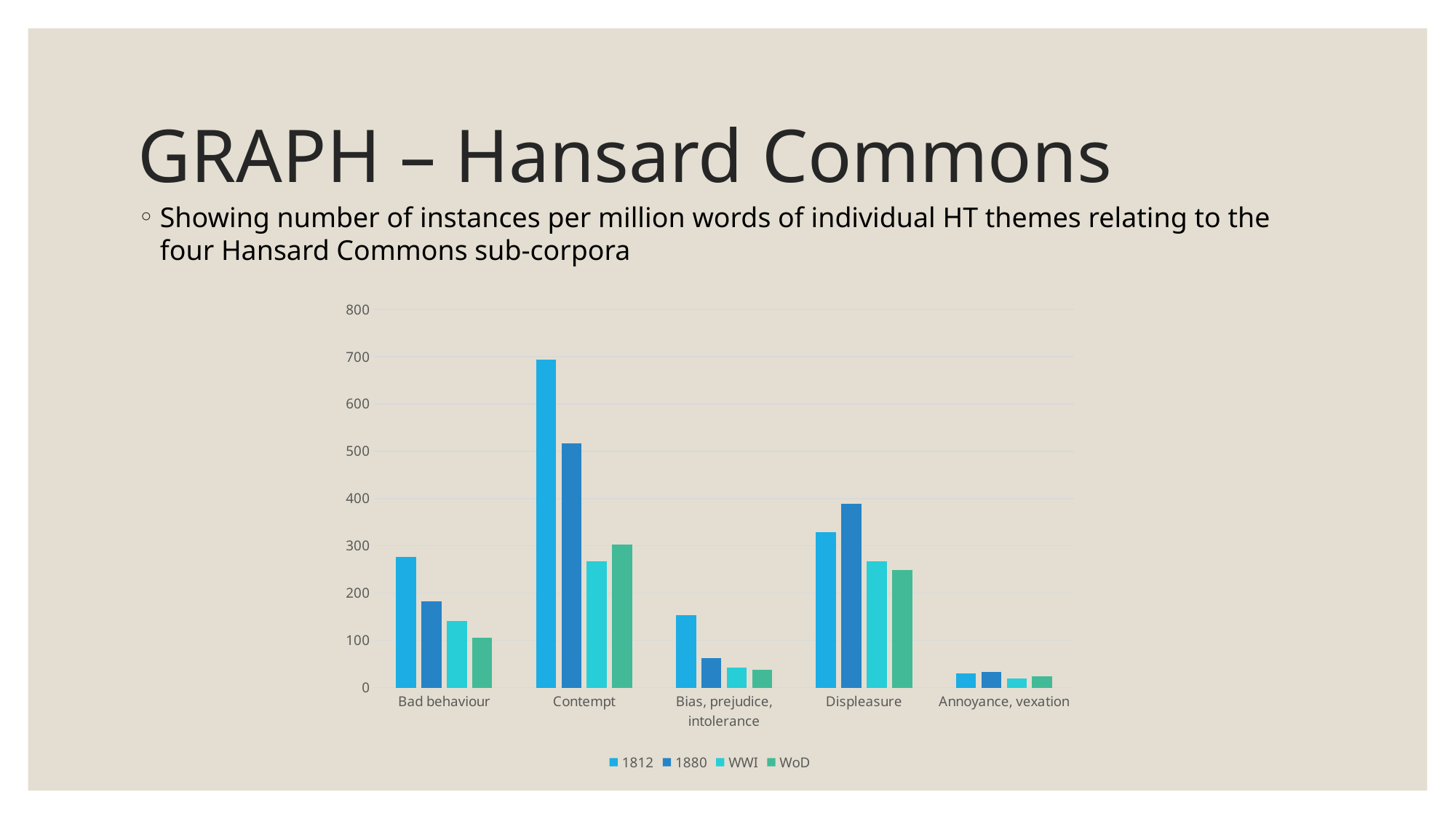
For Contempt, which series has the larger value, WWI or WoD? WoD Is the WoD value for Bad behaviour greater or less than 200? less Is the 1880 value for Contempt greater or less than 400? greater Which category has the highest value for the 1812 series? Contempt Is the 1812 value for Contempt greater or less than 600? greater How many series does the legend list? 4 For Displeasure, which series has the larger value, 1812 or 1880? 1880 How many categories are shown on the x axis? 5 Which category has the lowest value for the 1812 series? Annoyance, vexation What kind of chart is shown on the slide? bar chart What are the four series listed in the legend? 1812, 1880, WWI, WoD